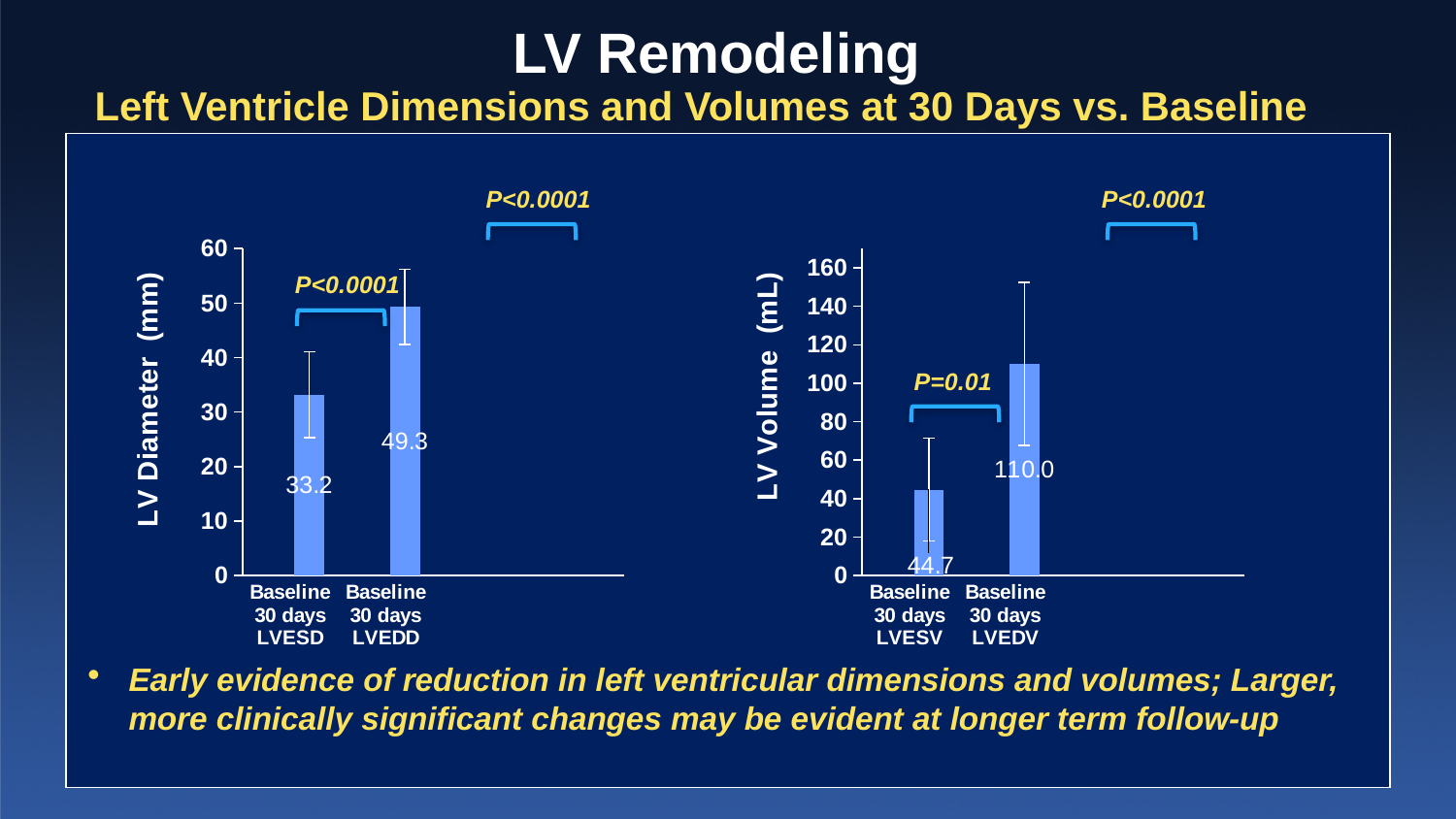
In the right chart (LV Volume), what P value is shown above the LVESV bar? P=0.01 In the left chart (LV Diameter), which bar is taller, LVESD or LVEDD? LVEDD What type of chart is used on the left side of the slide (LV Diameter)? Bar chart In the right chart (LV Volume), what is the difference between the LVEDV and LVESV values? 65.3 In the right chart (LV Volume), what is the value labeled on the LVESV bar? 44.7 In the right chart (LV Volume), which bar has the lowest value? LVESV In the right chart (LV Volume), is the LVEDV value greater or less than 100? greater In the right chart (LV Volume), what is the value labeled on the LVEDV bar? 110.0 What is the y-axis label of the right chart? LV Volume (mL) In the left chart (LV Diameter), what is the value labeled on the LVESD bar? 33.2 In the left chart (LV Diameter), what is the difference between the LVEDD and LVESD values? 16.1 In the left chart (LV Diameter), what is the value labeled on the LVEDD bar? 49.3